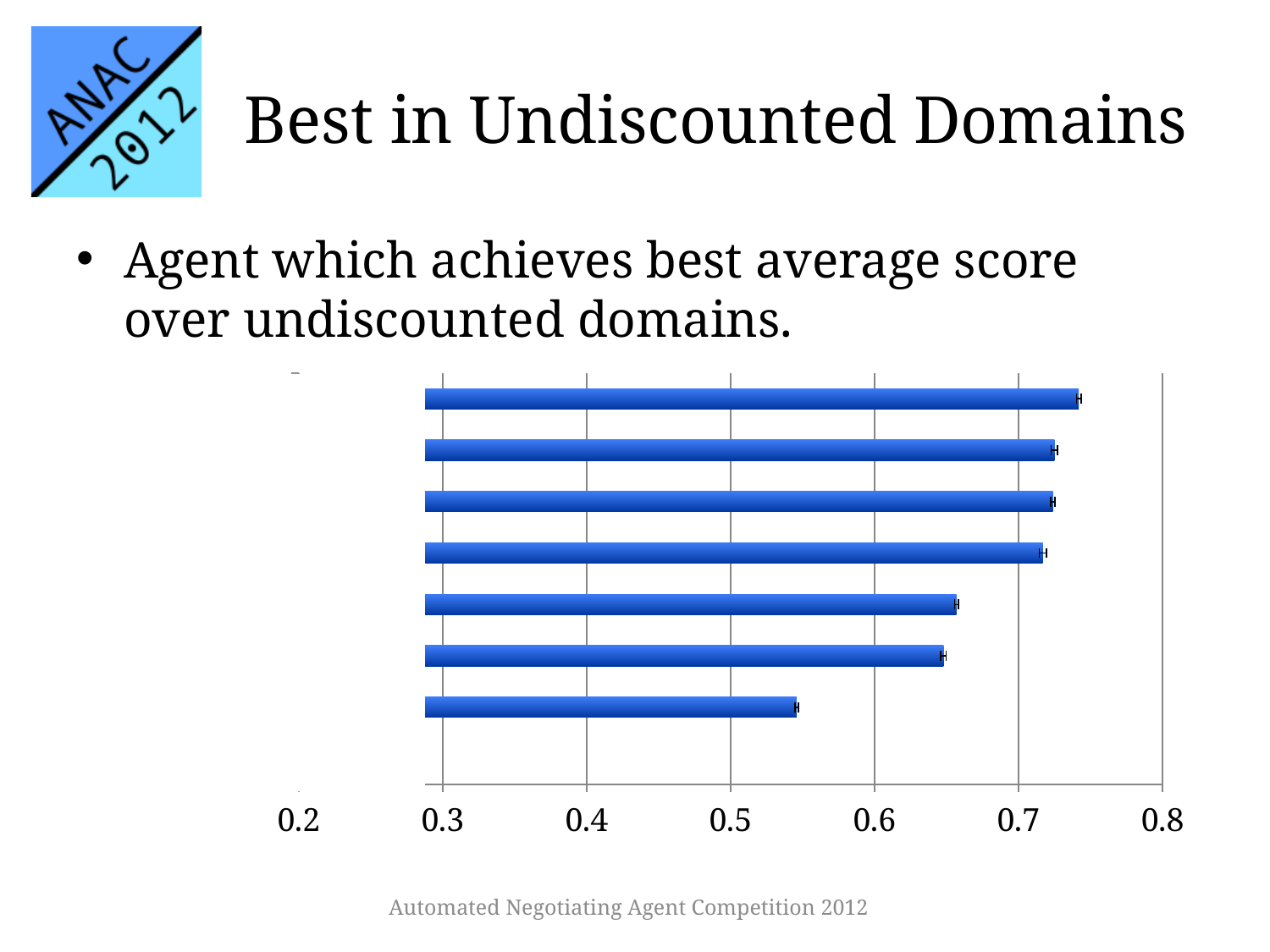
How many bars are plotted in the chart? 7 What are the minimum and maximum values shown on the horizontal axis of the chart? 0.2 and 0.8 Is the value of the top bar greater or less than 0.7? greater Which bar in the chart has the lowest value? the bottom bar Is the value of the fifth bar from the top greater or less than 0.6? greater Is the value of the bottom bar greater or less than 0.5? greater Which bar in the chart has the highest value? the top bar Which is larger, the value of the fourth bar from the top or the fifth bar from the top? the fourth bar from the top Which is larger, the value of the top bar or the value of the bottom bar? the top bar What kind of chart is shown on the slide? bar chart